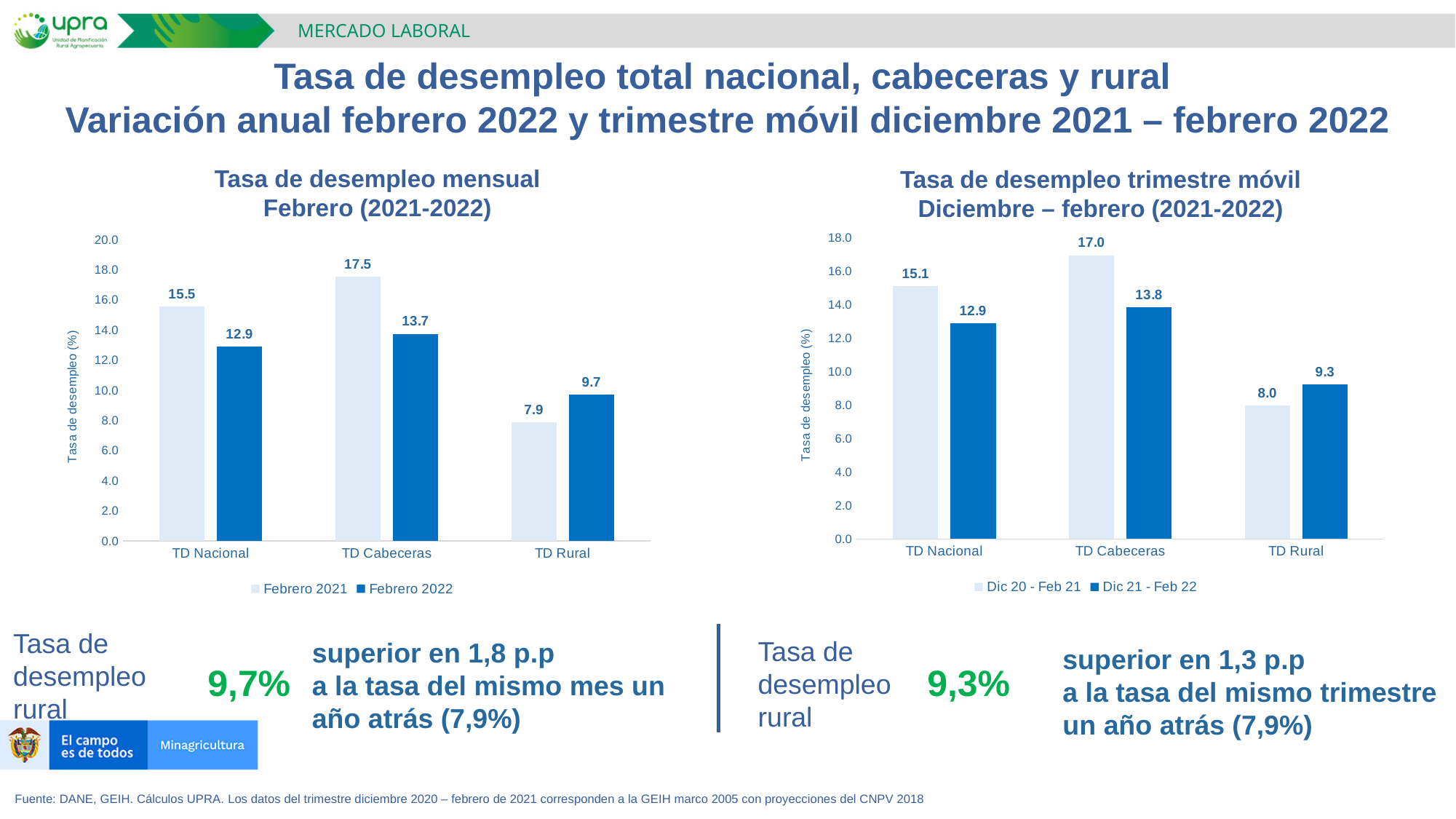
In the left chart (Tasa de desempleo mensual Febrero), which category has the lowest value for Febrero 2022? TD Rural In the left chart (Tasa de desempleo mensual Febrero), how many categories are shown on the x axis? 3 What type of chart is the left chart (Tasa de desempleo mensual Febrero)? Bar chart In the left chart (Tasa de desempleo mensual Febrero), what is the y-axis label? Tasa de desempleo (%) In the right chart (Tasa de desempleo trimestre móvil), what is the difference between the Dic 21 - Feb 22 and Dic 20 - Feb 21 values for TD Rural? 1.3 In the right chart (Tasa de desempleo trimestre móvil), how many series does the legend list? 2 In the left chart (Tasa de desempleo mensual Febrero), what is the difference between the Febrero 2021 and Febrero 2022 values for TD Cabeceras? 3.8 In the left chart (Tasa de desempleo mensual Febrero), what is the value for TD Nacional in Febrero 2022? 12.9 In the right chart (Tasa de desempleo trimestre móvil), which category has the highest value for Dic 20 - Feb 21? TD Cabeceras In the right chart (Tasa de desempleo trimestre móvil), which is larger for TD Nacional: Dic 20 - Feb 21 or Dic 21 - Feb 22? Dic 20 - Feb 21 In the left chart (Tasa de desempleo mensual Febrero), what is the value for TD Cabeceras in Febrero 2021? 17.5 In the right chart (Tasa de desempleo trimestre móvil), what is the value for TD Rural in Dic 21 - Feb 22? 9.3